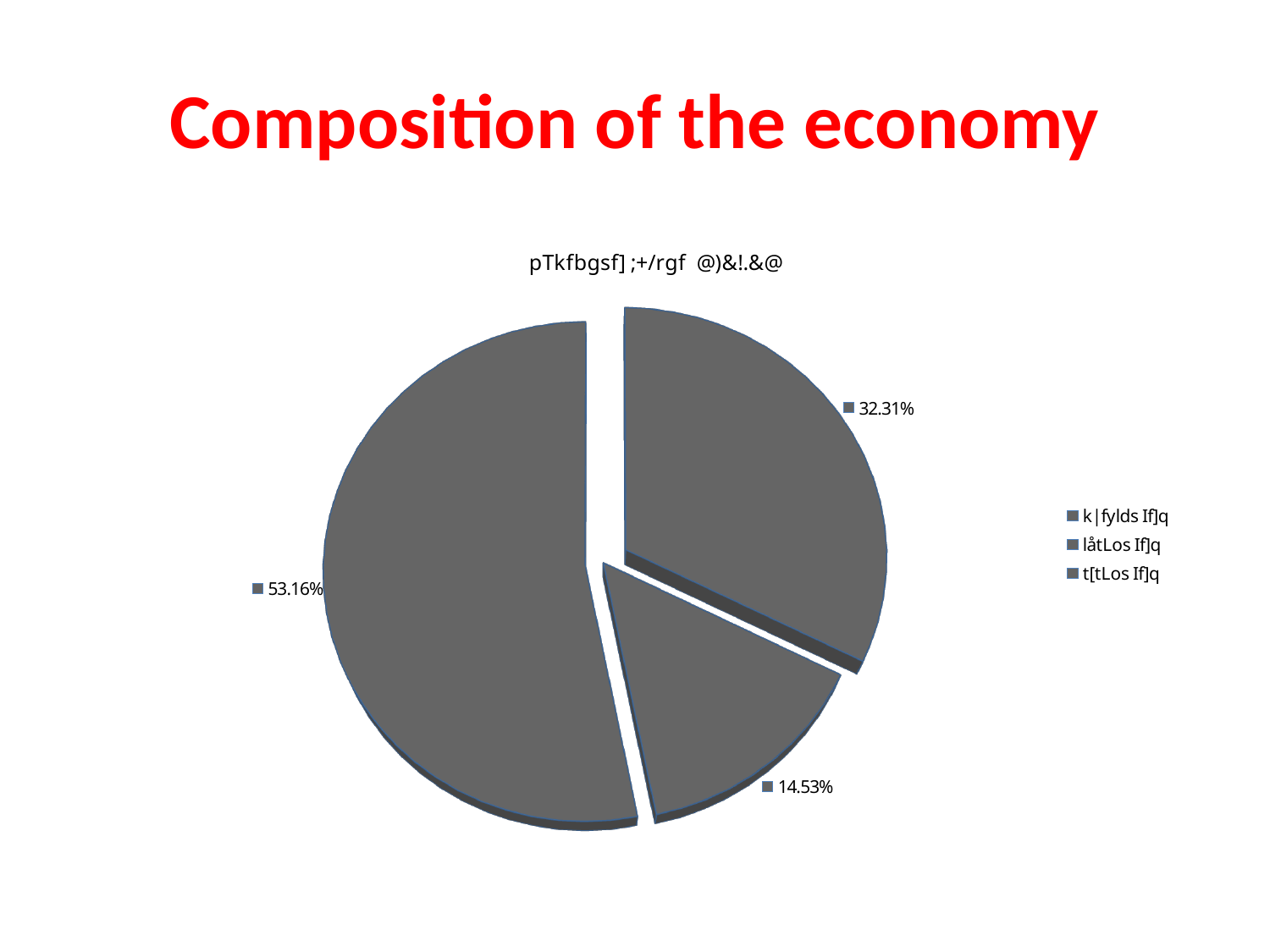
Is the largest slice of the pie chart greater or less than 50%? greater What is the value of the largest slice of the pie chart? 53.16% How many slices does the pie chart have? 3 How many entries does the legend of the pie chart list? 3 What is the difference between the largest slice (53.16%) and the smallest slice (14.53%)? 38.63 percentage points What is the value of the smallest slice of the pie chart? 14.53% What is the difference between the slice labelled 32.31% and the slice labelled 14.53%? 17.78 percentage points Which is larger, the slice labelled 32.31% or the slice labelled 14.53%? 32.31% What kind of chart is shown on the slide? pie chart What is the title of the slide? Composition of the economy What is the difference between the largest slice (53.16%) and the slice labelled 32.31%? 20.85 percentage points What do the three slice percentages of the pie chart add up to? 100.00%